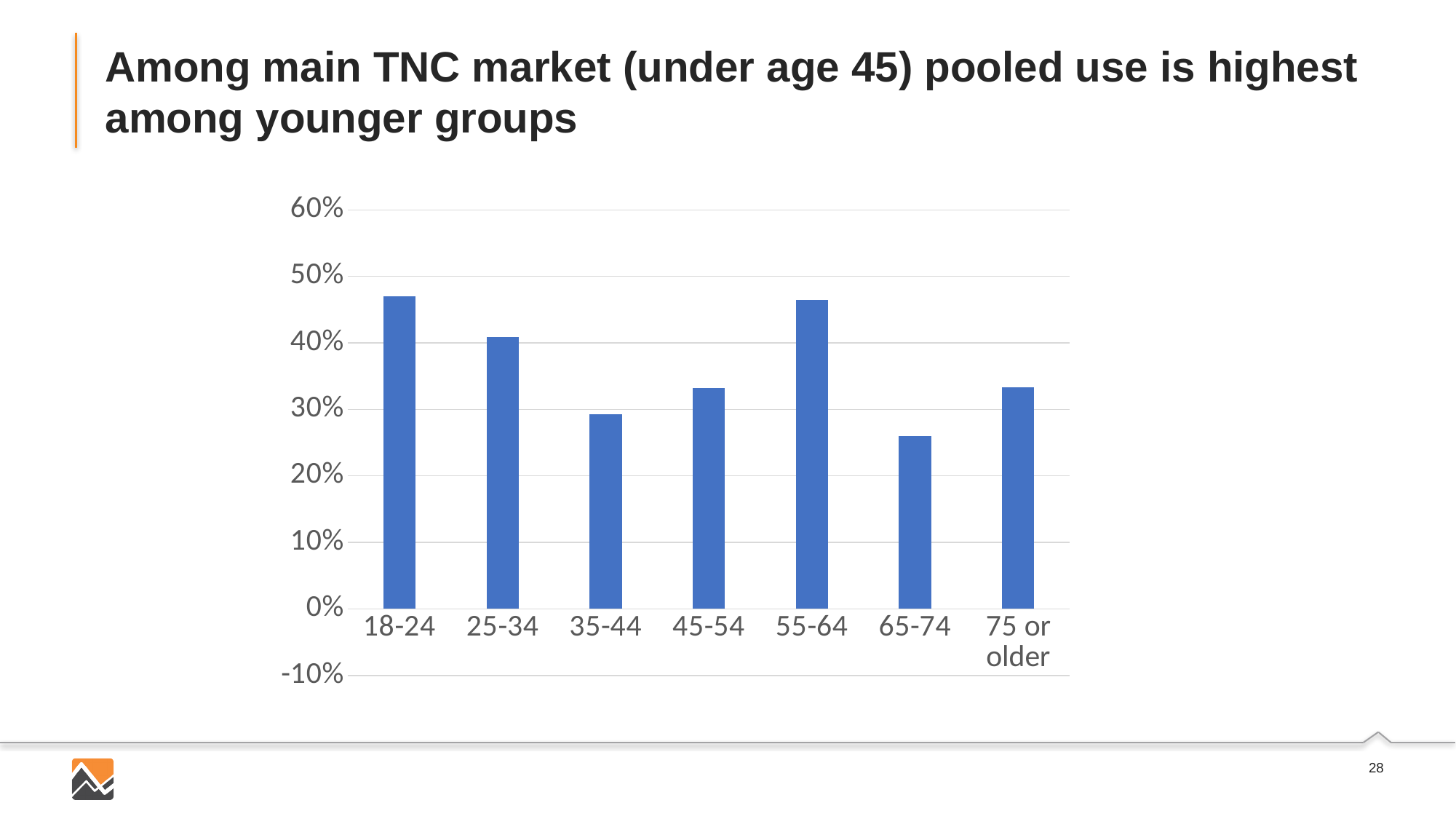
What kind of chart is shown on the slide? bar chart Do the values rise or fall from the 18-24 group to the 35-44 group? fall Is the value for the 25-34 age group greater or less than 50%? less Which has the larger value, the 25-34 age group or the 35-44 age group? 25-34 Which has the larger value, the 55-64 age group or the 65-74 age group? 55-64 Which age group has the lowest value in the chart? 65-74 What is the highest value labelled on the y axis of the chart? 60% Is the value for the 18-24 age group greater or less than 40%? greater Is the value for the 65-74 age group greater or less than 30%? less How many age groups are shown on the x axis of the chart? 7